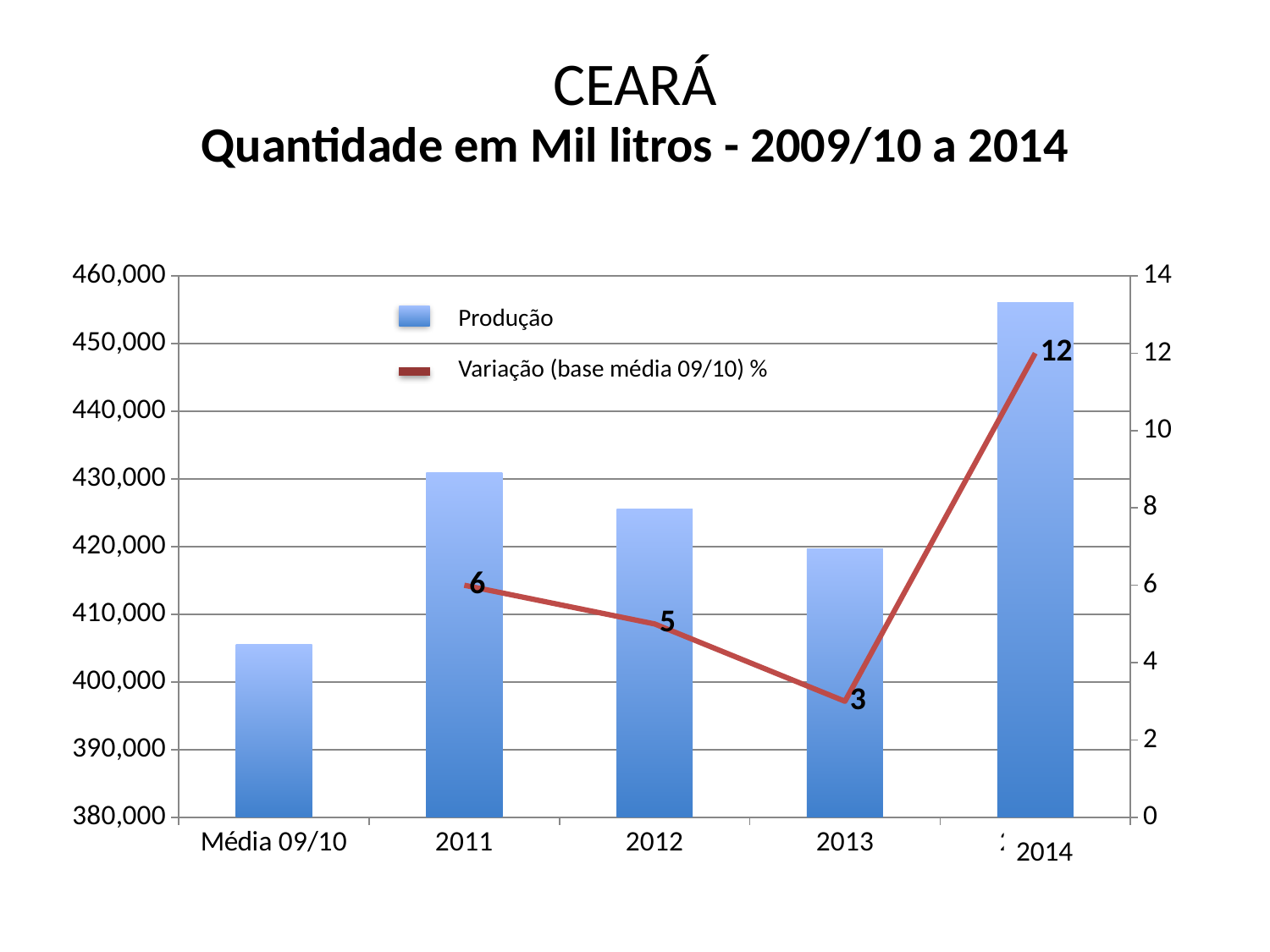
What is the difference between the Variação values for 2014 and 2013? 9 How many series does the legend list? 2 What is the value of Variação (base média 09/10) % for 2013? 3 Which category has the tallest Produção bar? 2014 Which year has the highest Variação (base média 09/10) % value? 2014 Is the Produção bar for 2011 taller or shorter than the bar for 2012? taller Which category has the shortest Produção bar? Média 09/10 Is the Produção value for 2014 greater or less than 450,000? greater What is the value of Variação (base média 09/10) % for 2014? 12 How many categories are shown on the x axis? 5 What is the value of Variação (base média 09/10) % for 2011? 6 Which year has the lowest Variação (base média 09/10) % value? 2013